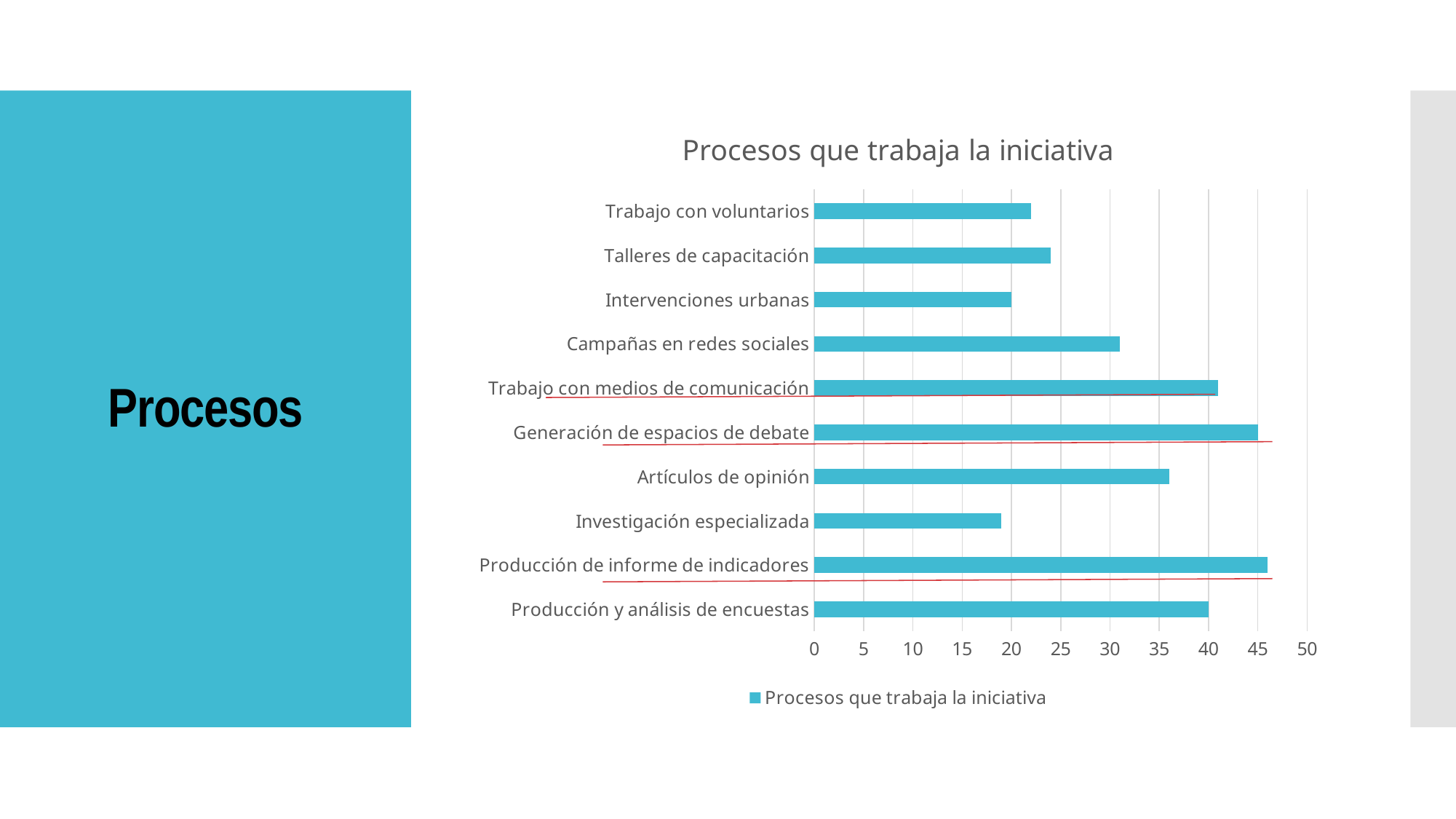
Is the value for Producción de informe de indicadores greater or less than 40? greater Is the value for Trabajo con voluntarios greater or less than 25? less Is the value for Campañas en redes sociales greater or less than 25? greater Which has the larger value, Artículos de opinión or Investigación especializada? Artículos de opinión What kind of chart is shown on the slide? bar chart Which has the larger value, Campañas en redes sociales or Trabajo con voluntarios? Campañas en redes sociales How many series does the legend list? 1 How many categories (processes) are plotted in the chart? 10 What is the title of the chart? Procesos que trabaja la iniciativa